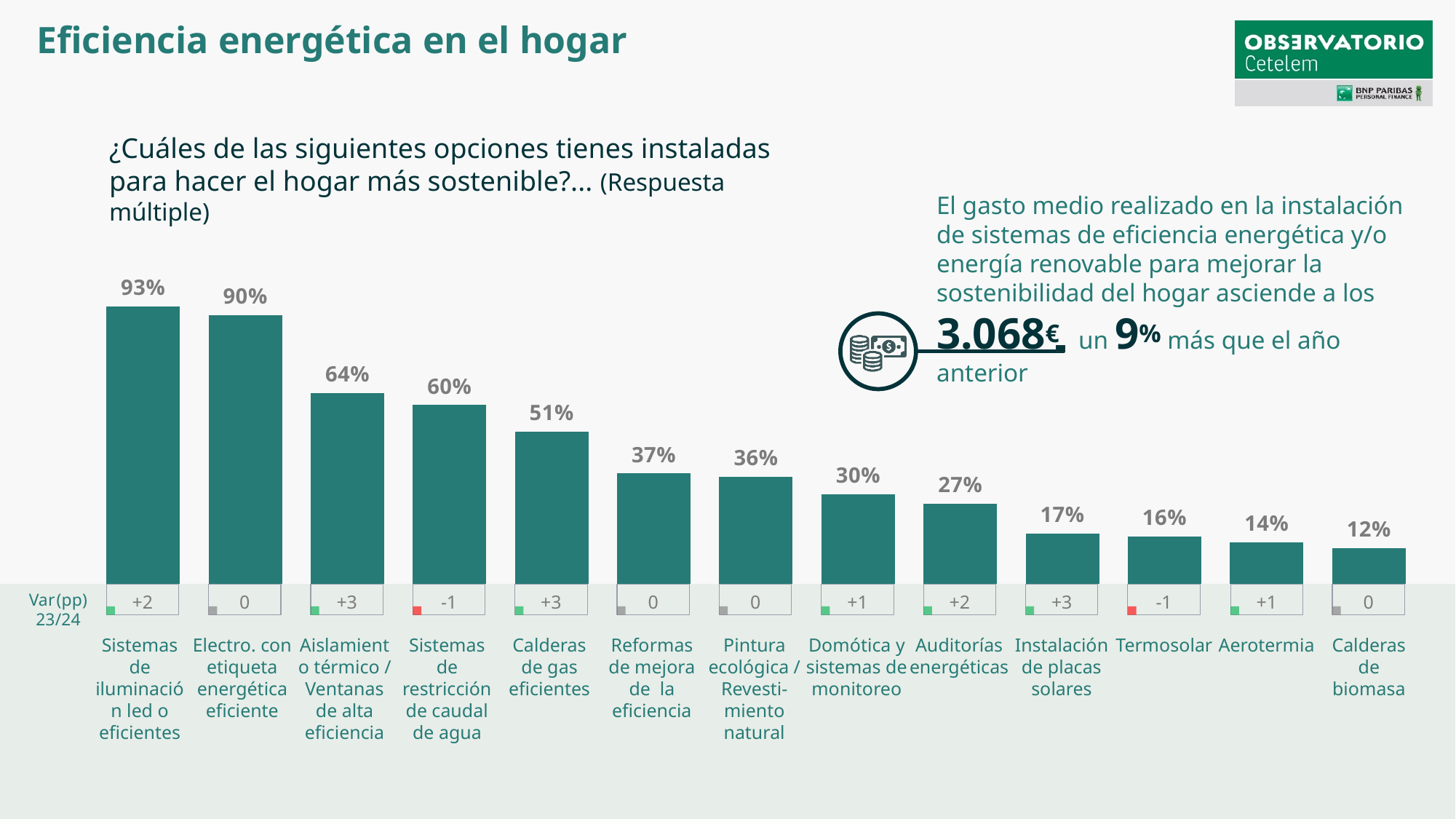
What is the average spend on energy efficiency installations stated on the slide? 3.068€ What is the value shown for 'Aerotermia'? 14% What is the Var(pp) 23/24 value shown for 'Termosolar'? -1 Which category has the highest value in the chart? Sistemas de iluminación led o eficientes Do the values rise or fall from left to right across the categories? Fall How many categories are shown in the bar chart? 13 Which category has the lowest value in the chart? Calderas de biomasa What is the difference in percentage points between 'Electro. con etiqueta energética eficiente' and 'Aislamiento térmico / Ventanas de alta eficiencia'? 26 What is the value shown for 'Calderas de gas eficientes'? 51% What percentage of respondents have 'Sistemas de iluminación led o eficientes' installed? 93% What kind of chart is shown on the slide? Bar chart Which is larger, the value for 'Reformas de mejora de la eficiencia' or the value for 'Domótica y sistemas de monitoreo'? Reformas de mejora de la eficiencia